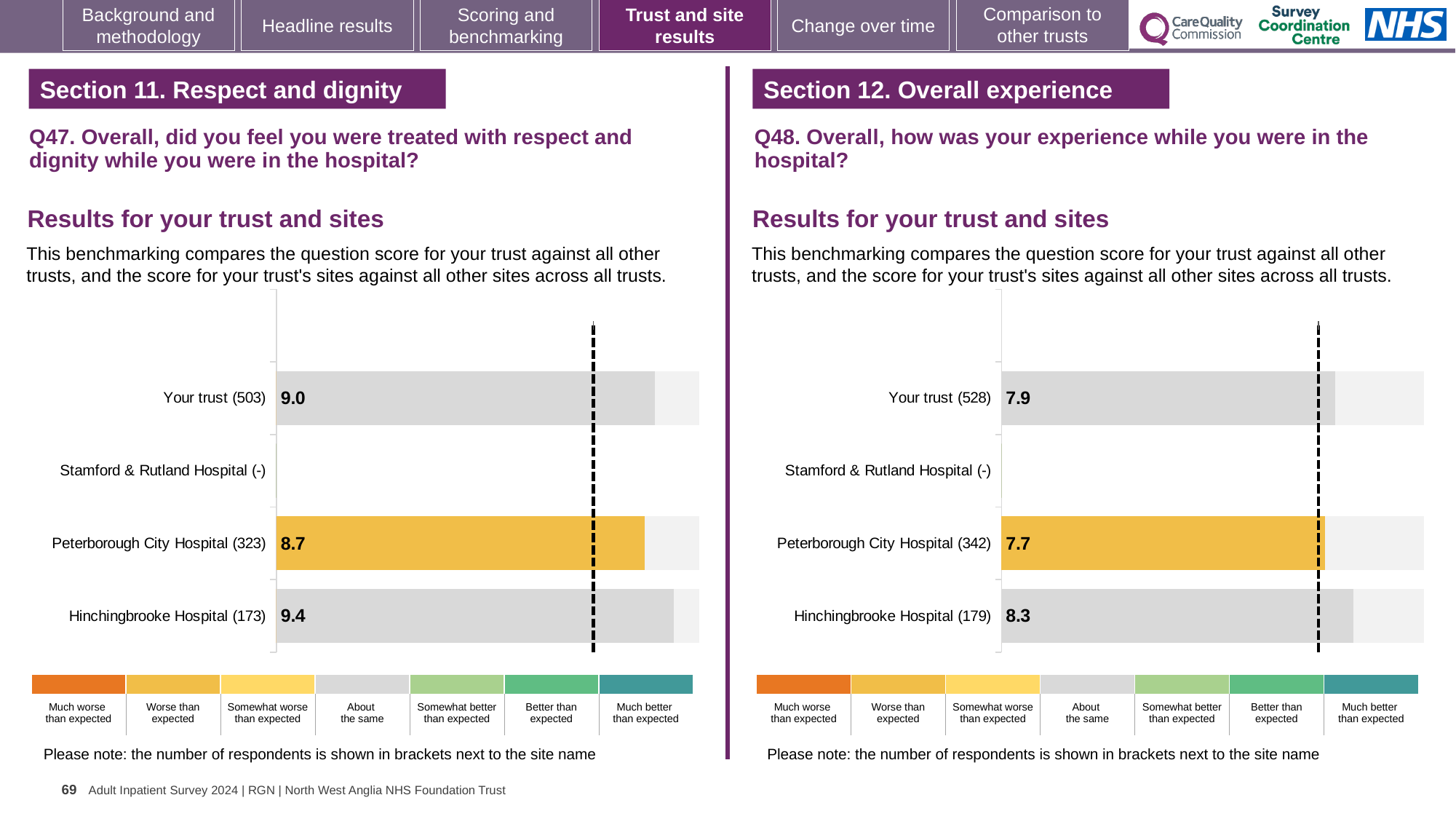
In the Q48 chart on the right, which has the higher score, Your trust or Peterborough City Hospital? Your trust In the Q47 chart on the left, which row has the highest score? Hinchingbrooke Hospital (173) In the Q48 chart on the right, which row with a plotted bar has the lowest score? Peterborough City Hospital (342) In the Q48 chart on the right, what is the score for Your trust (528)? 7.9 What kind of chart is used for the Q48 results on the right? Bar chart In the Q47 chart on the left, what is the difference between the scores for Hinchingbrooke Hospital and Peterborough City Hospital? 0.7 In the Q47 chart on the left, what is the score for Your trust (503)? 9.0 In the Q47 chart on the left, what is the score for Hinchingbrooke Hospital (173)? 9.4 In the Q48 chart on the right, what is the score for Peterborough City Hospital (342)? 7.7 In the Q47 chart on the left, which benchmark category does the colour of the Peterborough City Hospital bar correspond to? Worse than expected In the Q48 chart on the right, what is the difference between the scores for Hinchingbrooke Hospital and Your trust? 0.4 How many rows (trust and sites) are listed in the Q47 chart on the left? 4